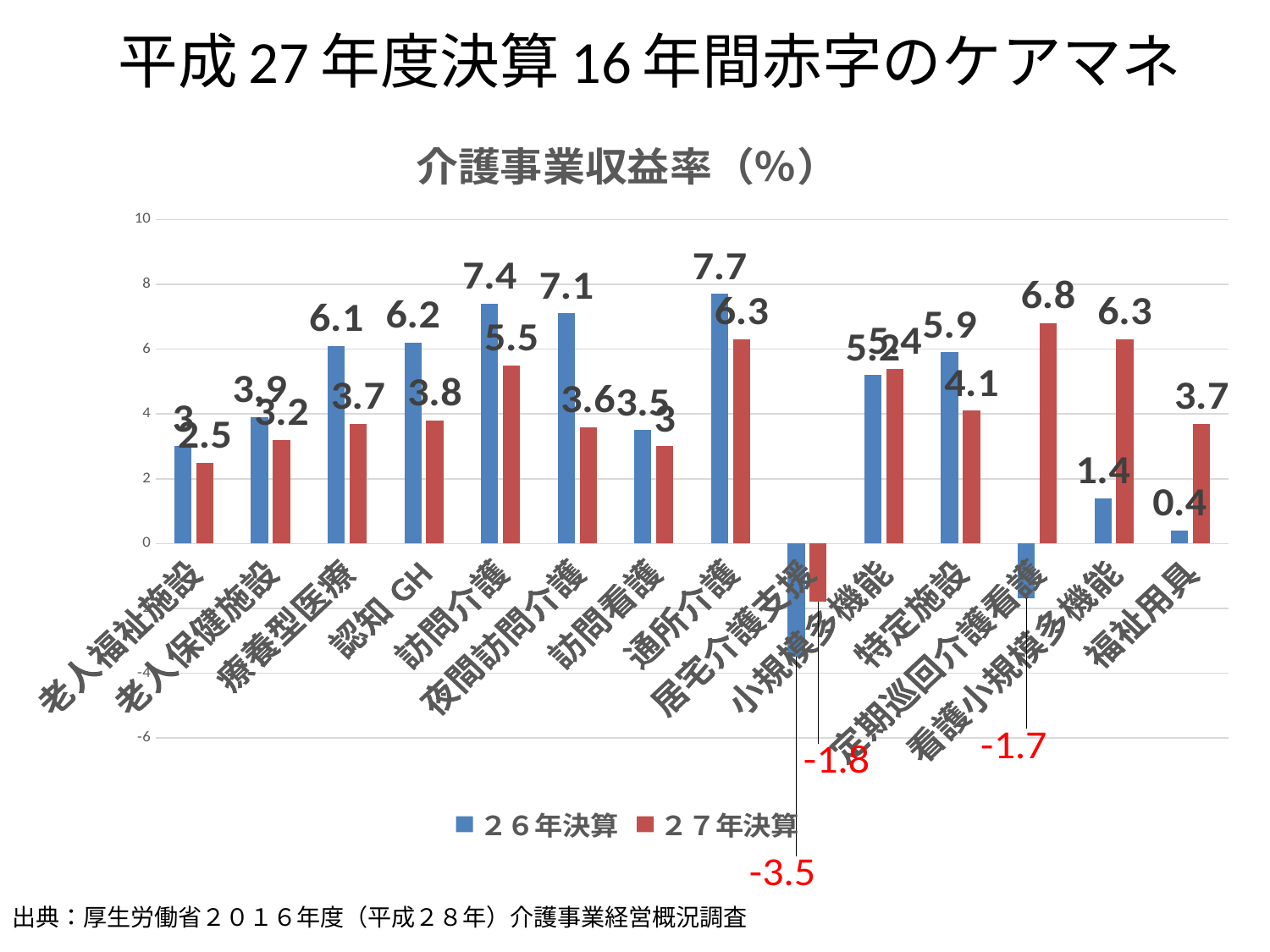
What is the 26年決算 value for 訪問介護? 7.4 How many categories are shown on the x axis? 14 What is the title of the chart? 介護事業収益率（%） What is the 26年決算 value for 居宅介護支援? -3.5 What type of chart is shown on the slide? bar chart Which category has the highest 26年決算 value? 通所介護 Which category has the lowest 27年決算 value? 居宅介護支援 Which category has the highest 27年決算 value? 定期巡回介護看護 For 看護小規模多機能, which is larger: the 26年決算 value or the 27年決算 value? 27年決算 What is the 27年決算 value for 通所介護? 6.3 How many series does the legend list? 2 What is the difference between the 26年決算 and 27年決算 values for 夜間訪問介護? 3.5